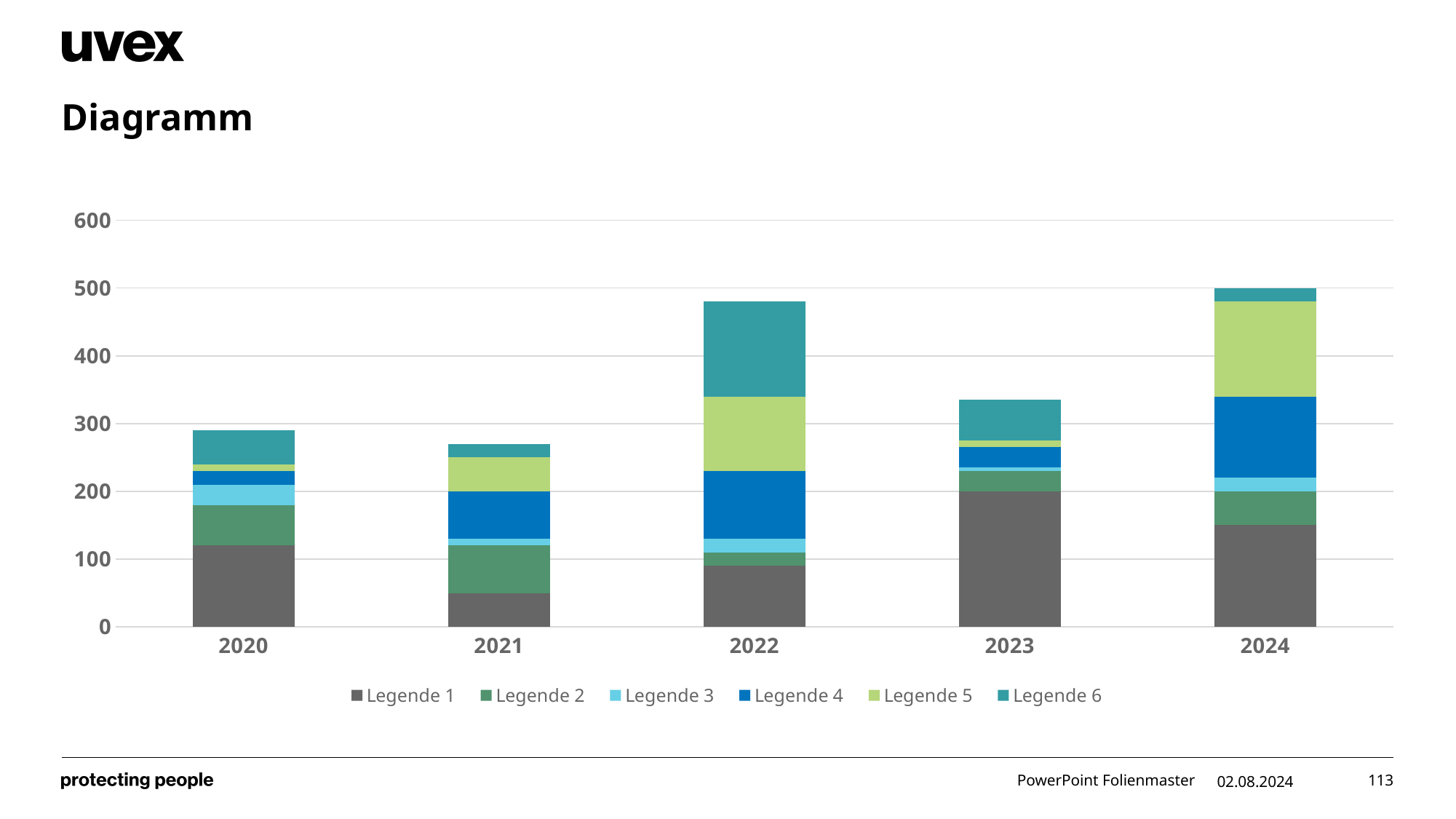
Which legend entry is shown in dark grey? Legende 1 Is the total stacked bar for 2023 greater or less than 300? greater Which stacked bar is taller, 2022 or 2023? 2022 Is the total stacked bar for 2022 greater or less than 400? greater What is the title of the chart slide? Diagramm Is the total stacked bar for 2021 greater or less than 300? less Which year has the tallest stacked bar? 2024 What type of chart is shown on the slide? stacked bar chart Does the total bar height rise or fall from 2021 to 2022? rise How many years are shown on the x axis of the chart? 5 How many series does the legend list? 6